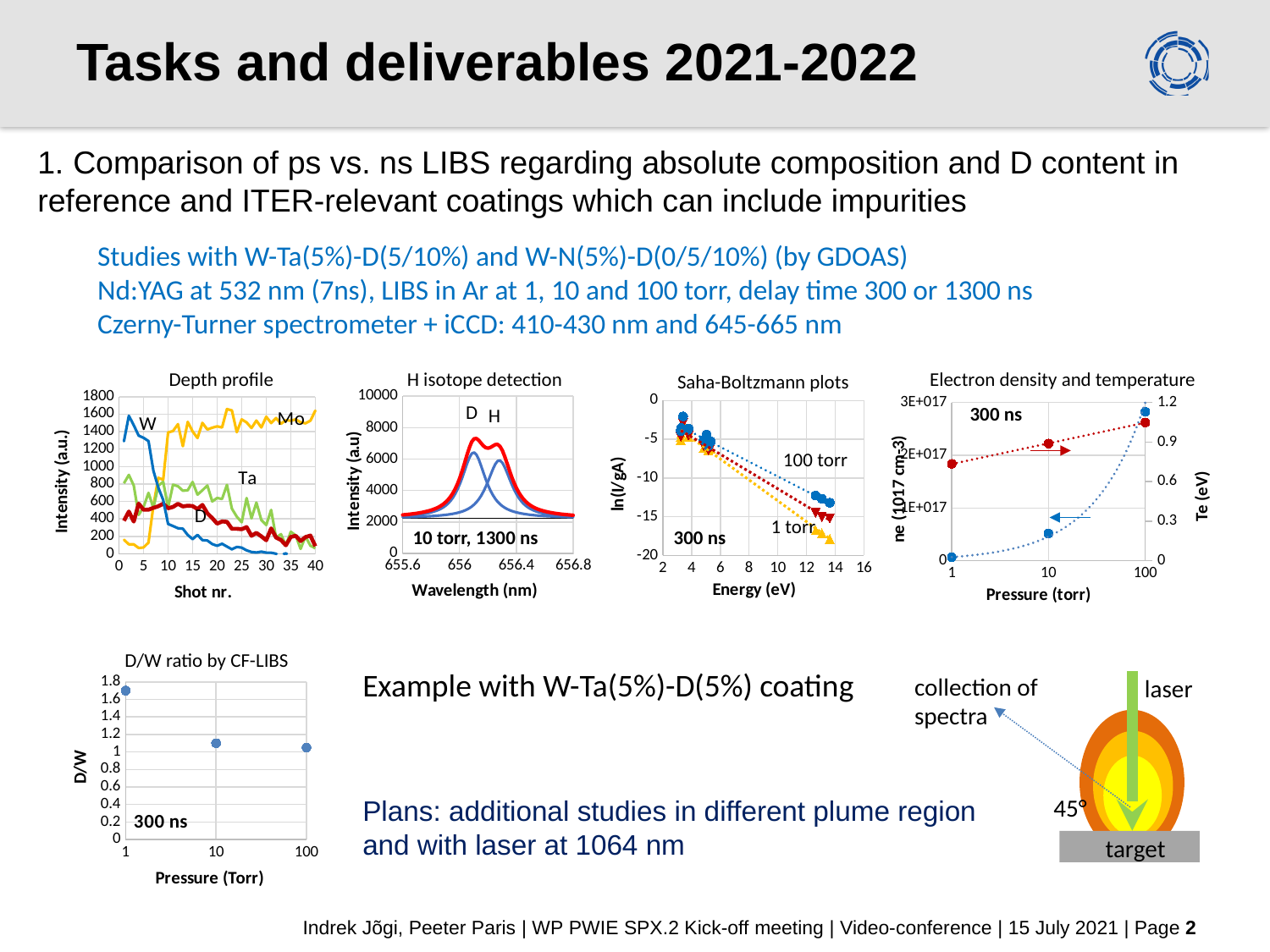
In the 'D/W ratio by CF-LIBS' chart, at which pressure is the D/W ratio highest? 1 Torr In the 'Depth profile' chart, does the W intensity rise or fall as the shot number increases? fall In the 'Depth profile' chart, is the intensity of Mo at shot 40 greater or less than 1000? greater In the 'Saha-Boltzmann plots' chart, does ln(I/gA) rise or fall as energy increases? fall In the 'H isotope detection' chart, what pressure and delay time are annotated on the plot? 10 torr, 1300 ns In the 'Depth profile' chart, what is the label on the x axis? Shot nr. What kind of chart is the 'H isotope detection' chart? line chart In the 'H isotope detection' chart, is the peak intensity of the D line greater or less than 6000? greater In the 'Depth profile' chart, is the intensity of D at shot 40 greater or less than 400? less In the 'Depth profile' chart, how many labelled series (elements) are plotted? 4 In the 'D/W ratio by CF-LIBS' chart, how many data points are plotted? 3